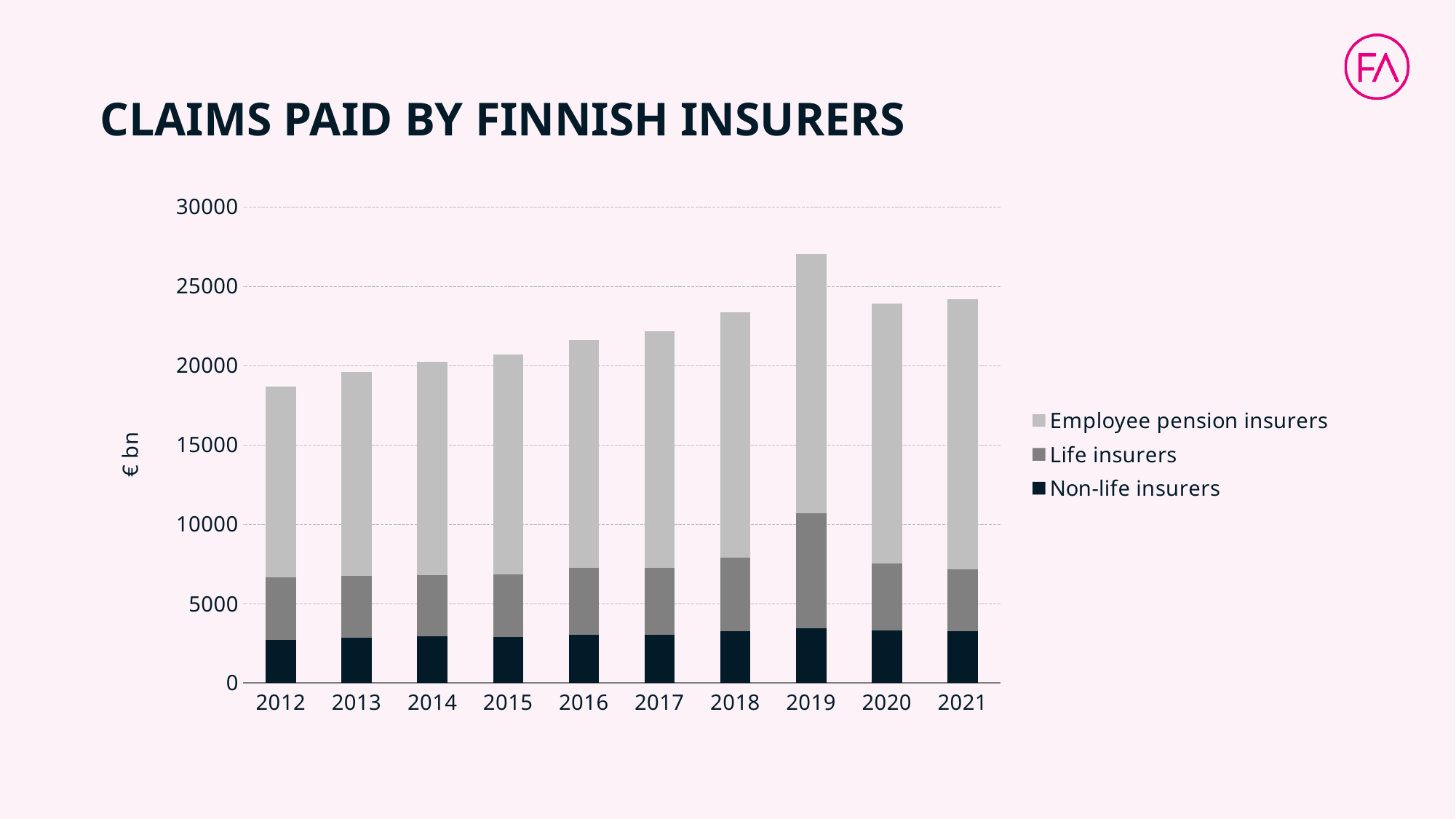
Which year has the lowest total claims paid? 2012 How many series does the chart's legend list? 3 What is the label on the chart's vertical axis? € bn Is the total value for 2021 greater or less than 25000? less Do the total claims paid generally rise or fall from 2012 to 2019? rise Is the total value for 2019 greater or less than 25000? greater Is the total value for 2016 greater or less than 20000? greater What kind of chart is shown on the slide? Stacked bar chart Which year has the largest Life insurers segment? 2019 How many years are shown on the x axis of the chart? 10 Which year has the highest total claims paid? 2019